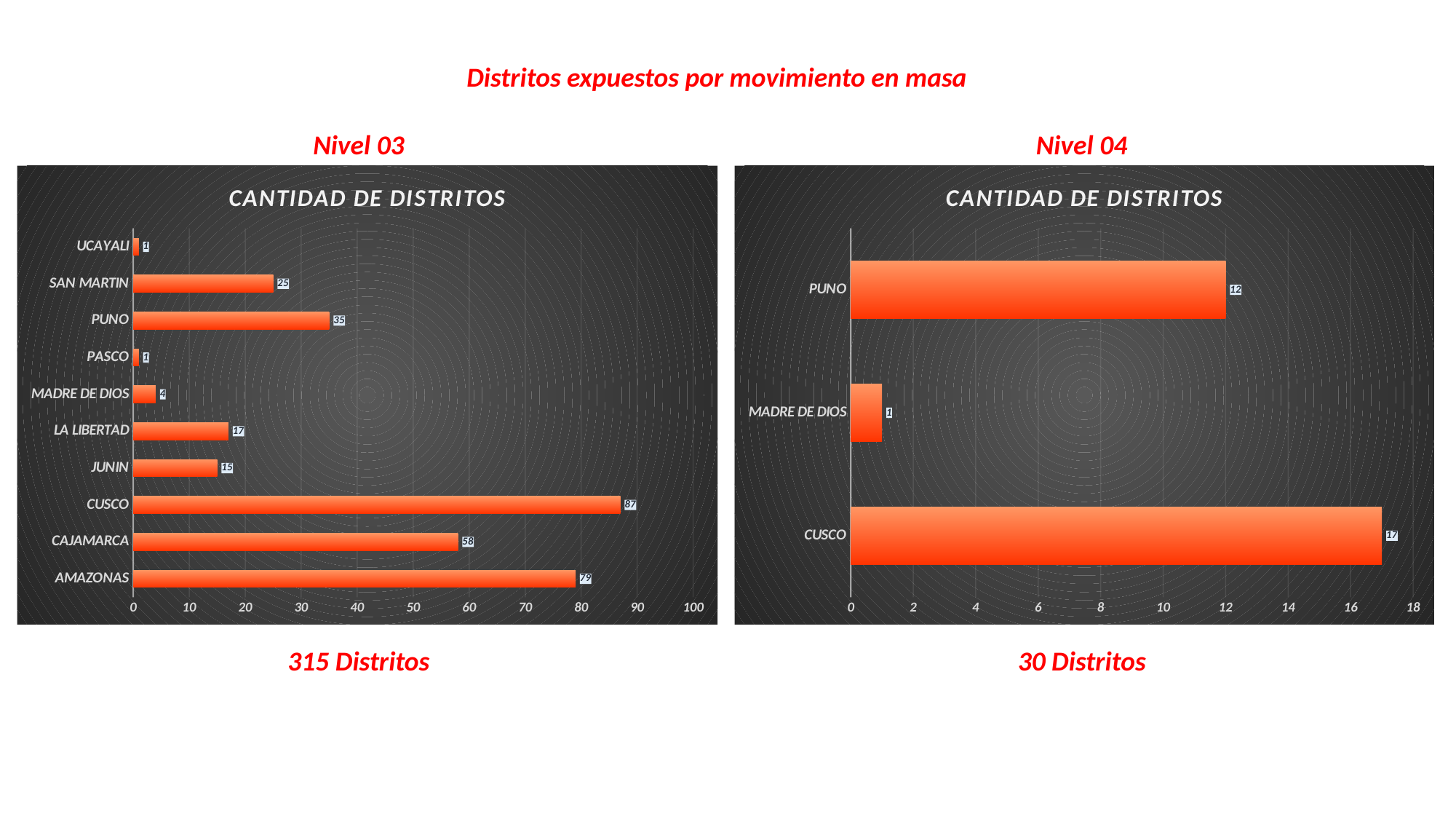
In the Nivel 03 chart, which category has the highest value? CUSCO In the Nivel 03 chart, what is the difference between AMAZONAS and CAJAMARCA? 21 In the Nivel 04 chart, how many categories are shown? 3 In the Nivel 04 chart, what is the value for PUNO? 12 In the Nivel 03 chart, what is the value for CAJAMARCA? 58 In the Nivel 03 chart, is the value for AMAZONAS greater or less than 70? greater What type of chart is the Nivel 04 chart? Bar chart In the Nivel 04 chart, what is the difference between CUSCO and PUNO? 5 In the Nivel 04 chart, which category has the lowest value? MADRE DE DIOS In the Nivel 03 chart, how many districts does CUSCO have? 87 In the Nivel 03 chart, which is larger, PUNO or SAN MARTIN? PUNO In the Nivel 03 chart, how many categories are shown? 10